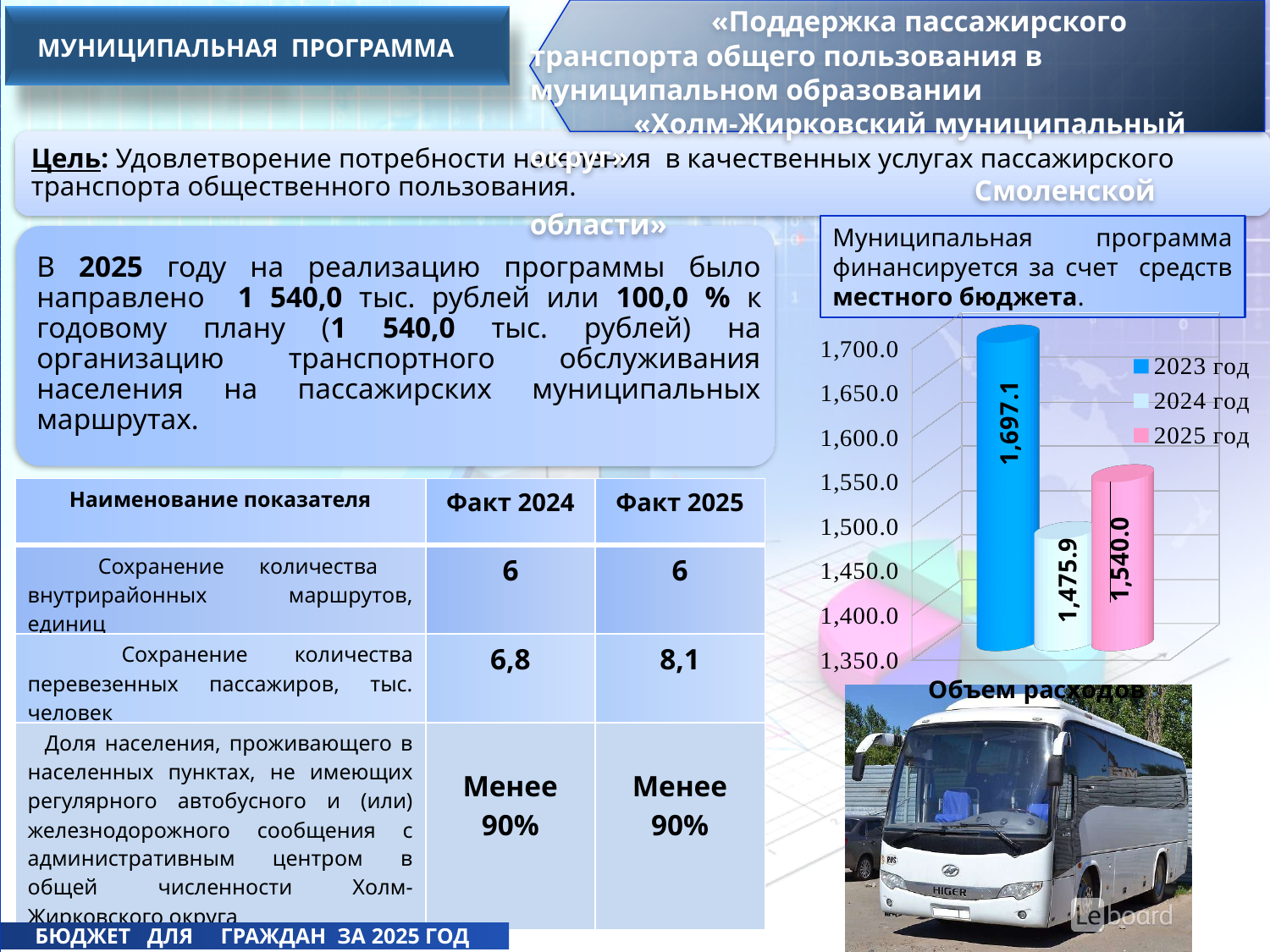
What is the title shown under the chart? Объем расходов What is the value for 2024 год in the chart? 1,475.9 What is the difference between the values for 2023 год and 2024 год? 221.2 Which year has the lowest value in the chart? 2024 год What is the difference between the values for 2025 год and 2024 год? 64.1 How many bars are plotted in the chart? 3 Which is larger, the value for 2024 год or the value for 2025 год? 2025 год How many entries does the chart legend list? 3 What is the value for 2025 год in the chart? 1,540.0 What type of chart is shown on the slide? bar chart Which year has the highest value in the chart? 2023 год What is the value for 2023 год in the chart? 1,697.1